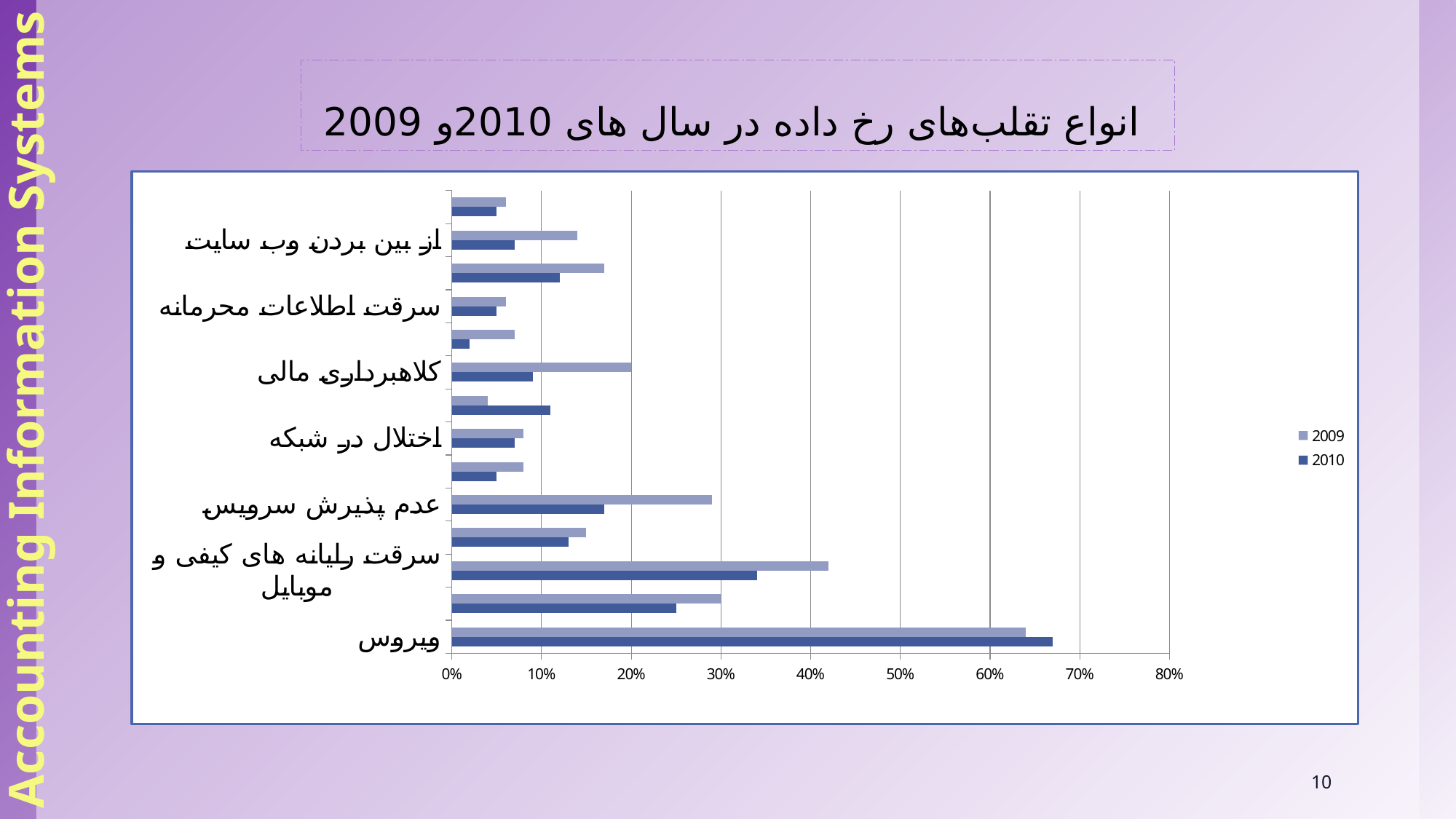
Is the 2010 value for ویروس greater or less than 60%? greater Is the 2009 value for اختلال در شبکه greater or less than 20%? less How many series does the legend list? 2 Which is larger, the 2010 value for ویروس or the 2010 value for عدم پذیرش سرویس? ویروس Which category has the highest value in the chart? ویروس What is the maximum value shown on the horizontal axis? 80% Is the 2010 value for عدم پذیرش سرویس greater or less than 20%? less Which two series are listed in the legend? 2009 and 2010 What kind of chart is shown on the slide? bar chart